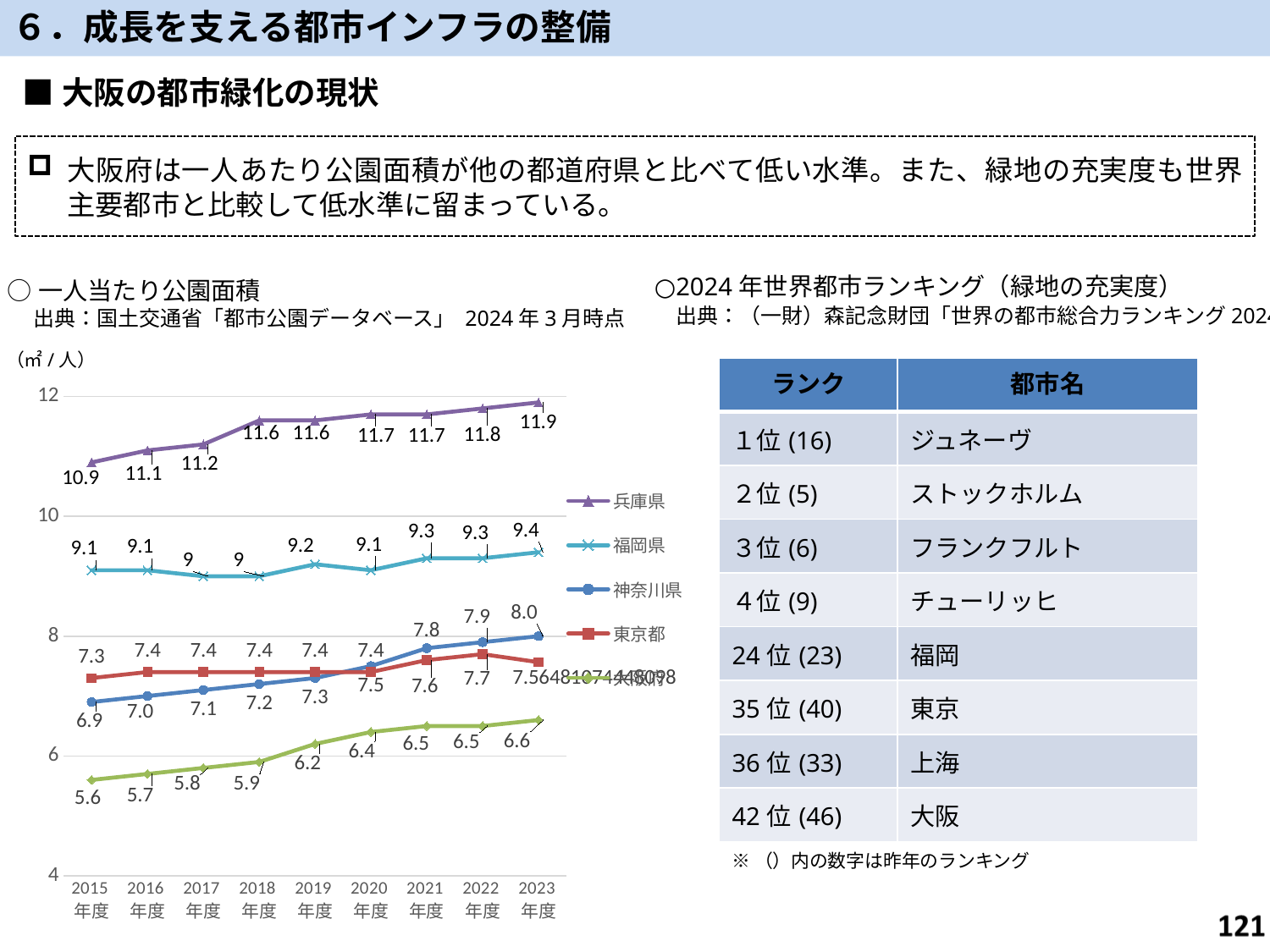
Which prefecture has the highest value in 2023年度? 兵庫県 What is the value for 神奈川県 in 2023年度? 8.0 How many fiscal years are shown on the x axis? 9 What is the value for 東京都 in 2015年度? 7.3 Does the value for 兵庫県 rise or fall from 2015年度 to 2023年度? rise What is the difference between the 兵庫県 values in 2023年度 and 2015年度? 1.0 Is the value for 福岡県 in 2023年度 greater or less than 10? less What is the value for 兵庫県 in 2023年度? 11.9 In 2021年度, which is larger: 神奈川県 or 東京都? 神奈川県 How many series does the legend list? 5 What kind of chart is used to show 一人当たり公園面積? line chart What is the value for 福岡県 in 2015年度? 9.1